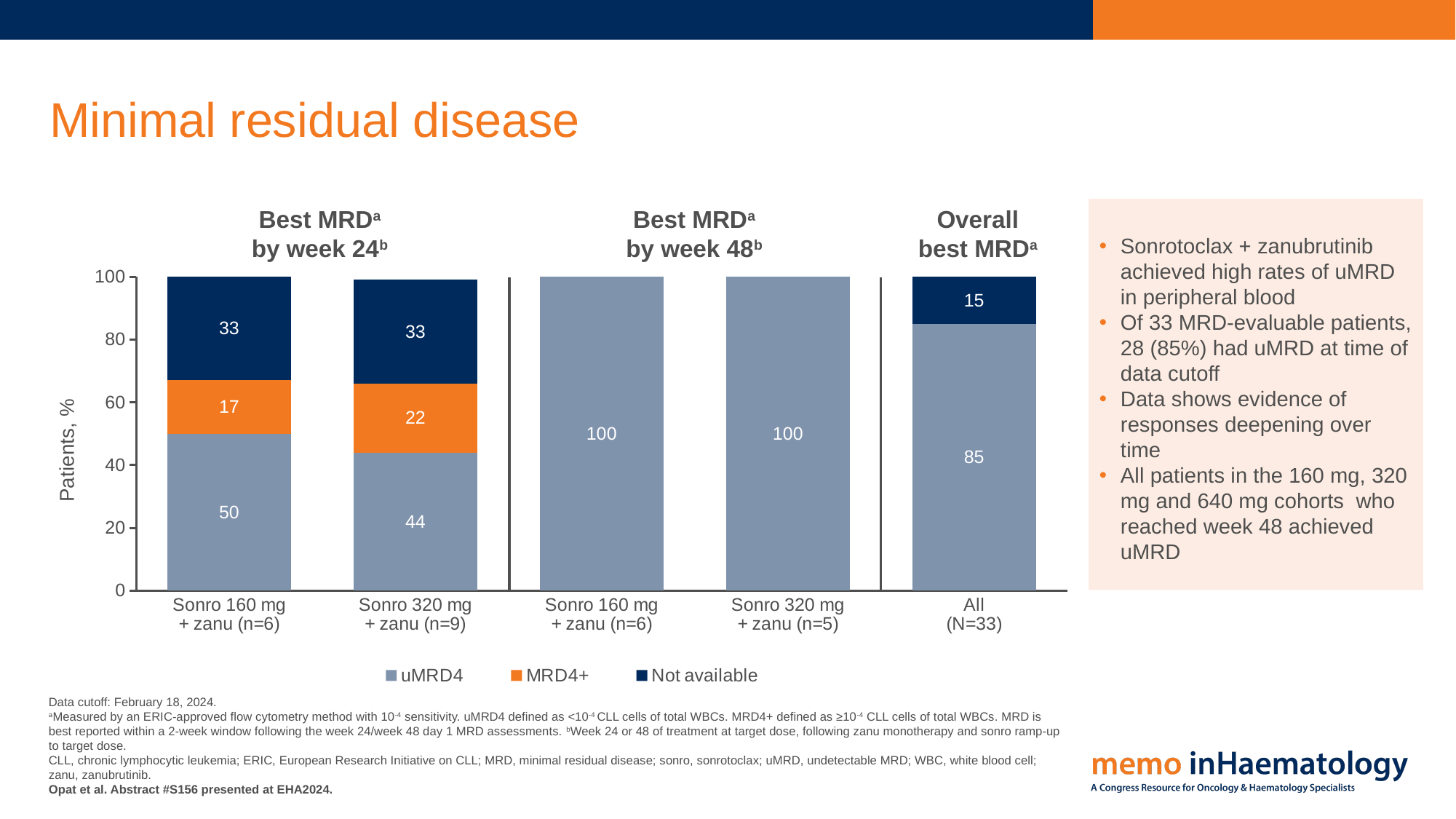
How many series does the legend list? 3 Which bar has the lowest uMRD4 value across the whole chart? Sonro 320 mg + zanu (n=9) How many bars are plotted on the chart in total? 5 What is the MRD4+ value for Sonro 320 mg + zanu (n=9) in the Best MRD by week 24 section? 22 What is the uMRD4 value for Sonro 160 mg + zanu (n=6) in the Best MRD by week 24 section? 50 In the Best MRD by week 24 section, what is the difference between the uMRD4 values for Sonro 160 mg + zanu (n=6) and Sonro 320 mg + zanu (n=9)? 6 What is the label of the y axis? Patients, % In the Best MRD by week 24 section, which bar has the larger MRD4+ value, Sonro 160 mg + zanu (n=6) or Sonro 320 mg + zanu (n=9)? Sonro 320 mg + zanu (n=9) What kind of chart is shown on the slide? Stacked bar chart What is the uMRD4 value for Sonro 320 mg + zanu (n=5) in the Best MRD by week 48 section? 100 What is the Not available value for All (N=33) in the Overall best MRD section? 15 Which colour represents the Not available series in the legend? Dark navy blue